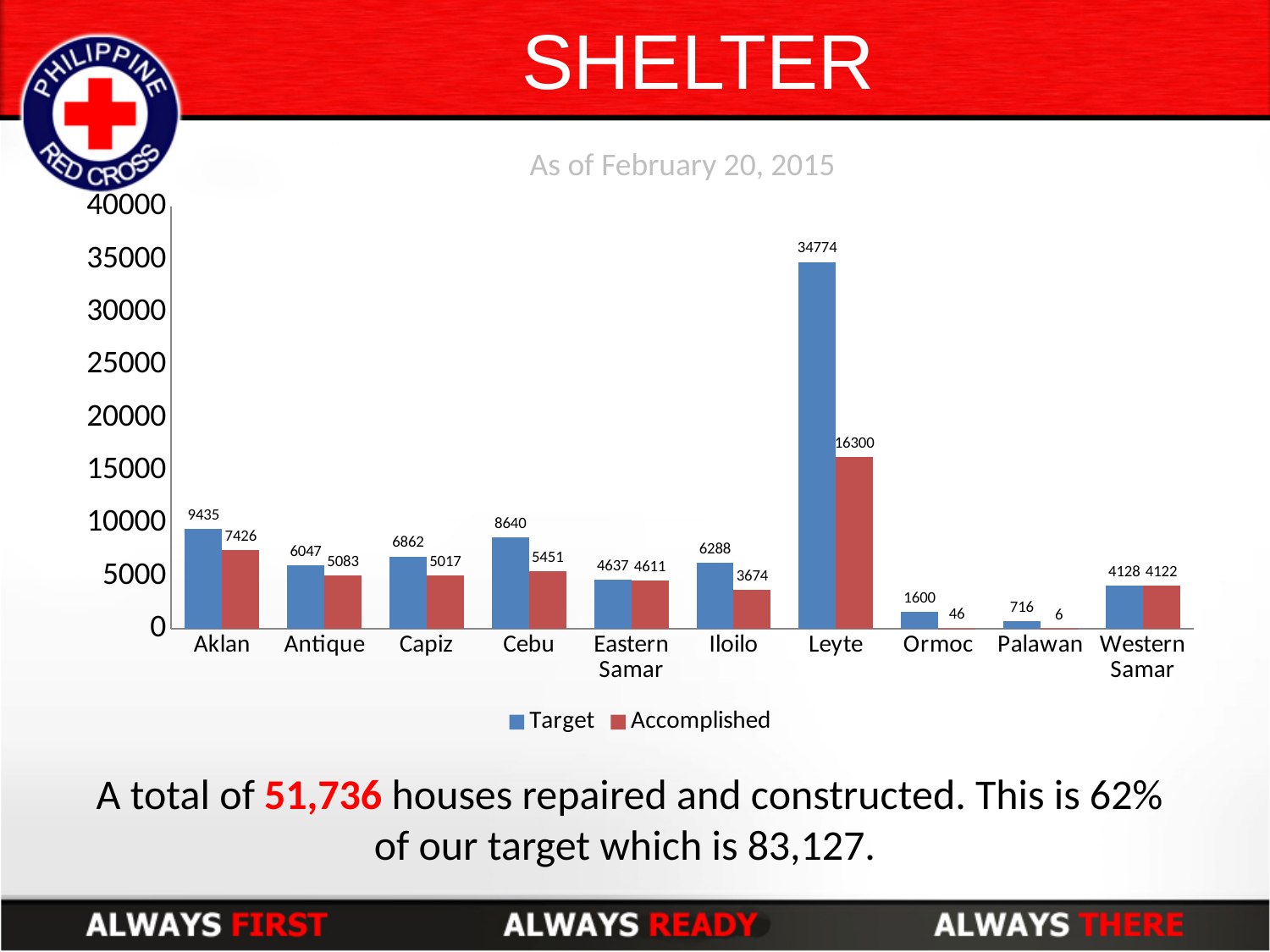
Which is larger, the Target value for Aklan or the Target value for Cebu? Aklan Which category has the lowest Accomplished value? Palawan What date is the chart data reported as of? February 20, 2015 Is the Accomplished value for Leyte greater or less than 15000? greater How many categories are shown on the x axis? 10 Which category has the highest Target value? Leyte What is the Accomplished value for Cebu? 5451 How many series does the legend list? 2 What is the Accomplished value for Palawan? 6 What is the Target value for Leyte? 34774 What is the difference between the Target and Accomplished values for Leyte? 18474 What kind of chart is shown on the slide? bar chart